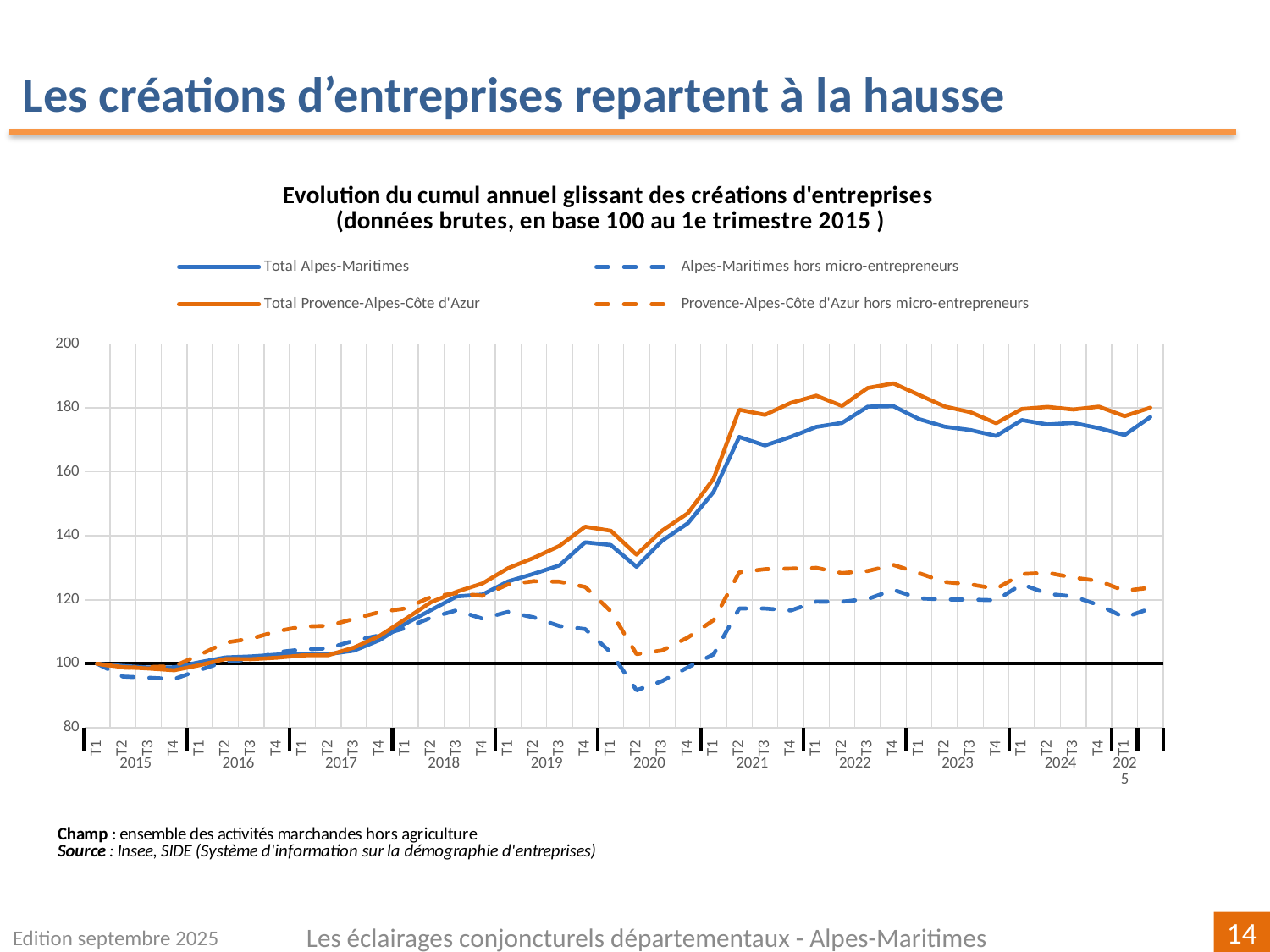
Which series are drawn with dashed lines? Alpes-Maritimes hors micro-entrepreneurs and Provence-Alpes-Côte d'Azur hors micro-entrepreneurs What kind of chart is shown on the slide? line chart Is the value for Total Alpes-Maritimes at T2 2020 greater or less than 140? less Is the value for Provence-Alpes-Côte d'Azur hors micro-entrepreneurs at T2 2021 greater or less than 120? greater Is the value for Alpes-Maritimes hors micro-entrepreneurs at T2 2020 greater or less than 100? less What is the value of all series at T1 2015? 100 In which quarter does the Alpes-Maritimes hors micro-entrepreneurs series reach its lowest value? T2 2020 At T4 2022, which is higher: Total Provence-Alpes-Côte d'Azur or Total Alpes-Maritimes? Total Provence-Alpes-Côte d'Azur What is the title of the chart? Evolution du cumul annuel glissant des créations d'entreprises (données brutes, en base 100 au 1e trimestre 2015 ) How many series does the legend list? 4 Does the Total Alpes-Maritimes series rise or fall overall from T1 2015 to T1 2025? rise